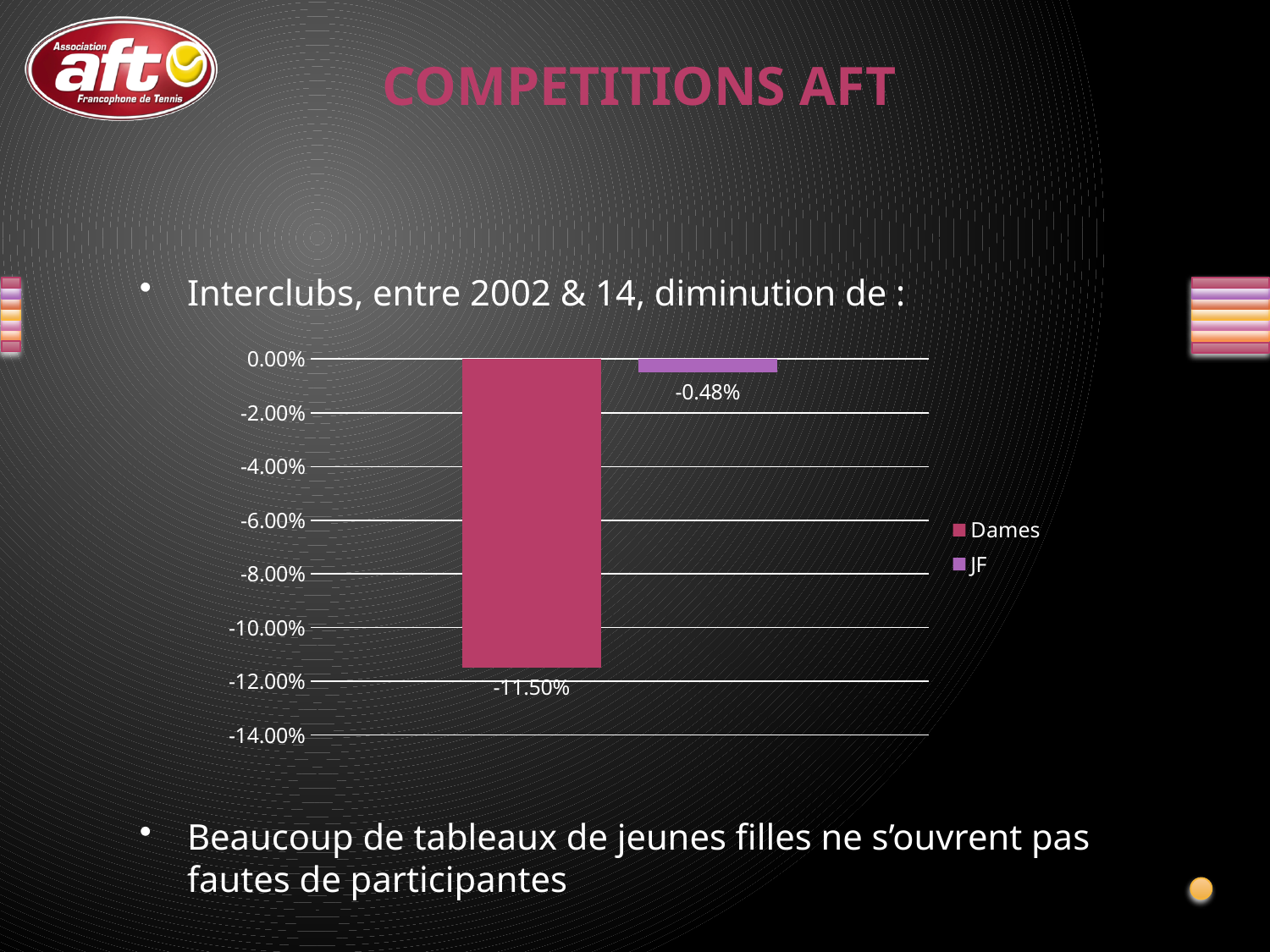
Is the value for JF greater or less than -2.00%? greater What are the two entries in the chart legend? Dames and JF What is the value for JF? -0.48% What kind of chart is shown on the slide? bar chart Which series has the lowest value? Dames What is the value for Dames? -11.50% Which series shows the larger decrease, Dames or JF? Dames What is the difference between the Dames value and the JF value? 11.02% Is the value for Dames greater or less than -10.00%? less How many series does the legend list? 2 Which series has the highest value? JF What is the lowest value shown on the vertical axis? -14.00%